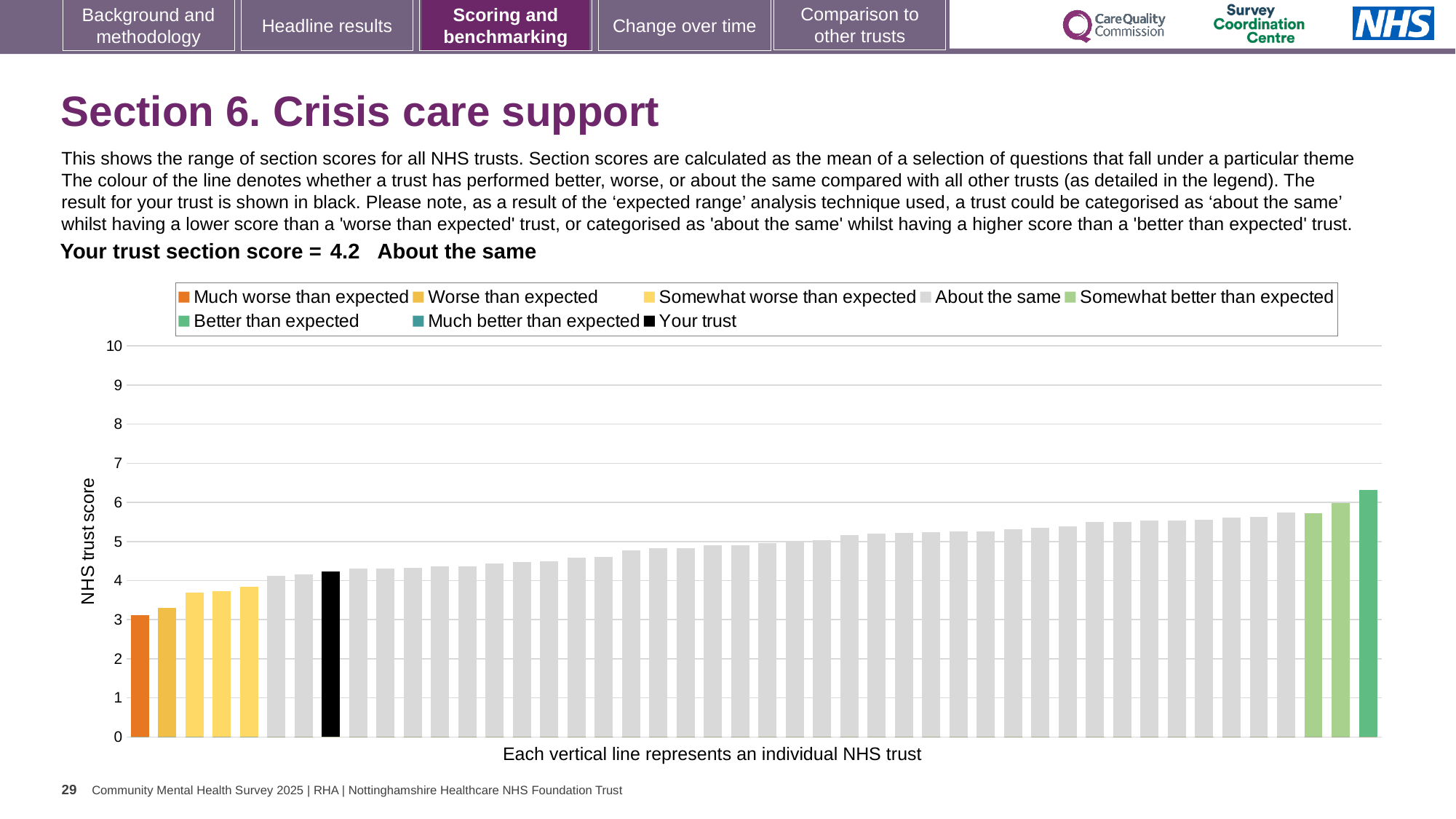
What kind of chart is shown on the slide? bar chart Is the value of the shortest bar greater or less than 4? less Which legend category does the shortest bar belong to? Much worse than expected Is the value of the black 'Your trust' bar greater or less than 4? greater Which category is your trust placed in for this section? About the same What is the label on the vertical axis of the chart? NHS trust score What is the section score for your trust shown on the slide? 4.2 Do the bar values rise or fall from left to right along the x axis? rise Is the value of the black 'Your trust' bar greater or less than 5? less How many entries does the chart legend list? 8 Which legend category does the tallest bar belong to? Better than expected